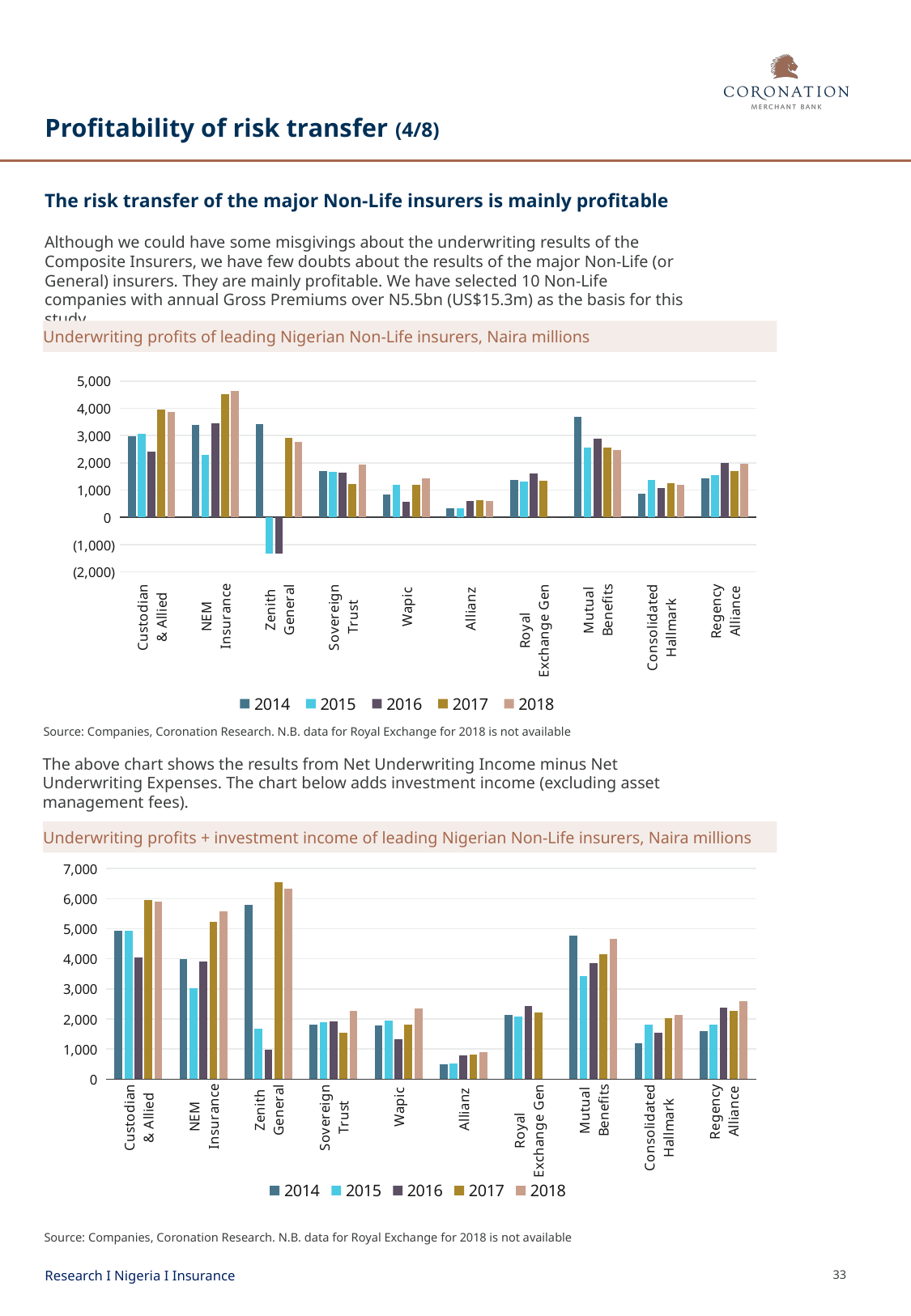
According to the source note under the charts, which insurer has no data for 2018? Royal Exchange In the bottom chart (Underwriting profits + investment income), which is larger for 2017: Zenith General or NEM Insurance? Zenith General In the top chart (Underwriting profits), is the 2014 value for Mutual Benefits greater or less than 3,000? greater In the top chart (Underwriting profits), how many insurers are shown on the x axis? 10 In the bottom chart (Underwriting profits + investment income), how many series does the legend list? 5 What kind of chart is the top chart, 'Underwriting profits of leading Nigerian Non-Life insurers'? Bar chart In the bottom chart (Underwriting profits + investment income), is the 2014 value for Zenith General greater or less than 5,000? greater In the bottom chart (Underwriting profits + investment income), which insurer has the tallest bar? Zenith General In the top chart (Underwriting profits), which insurer has the tallest bar? NEM Insurance In the top chart (Underwriting profits), which is larger for 2017: Custodian & Allied or NEM Insurance? NEM Insurance In the top chart (Underwriting profits), which insurer has bars below zero? Zenith General In the bottom chart (Underwriting profits + investment income), is the 2014 value for Allianz greater or less than 1,000? less